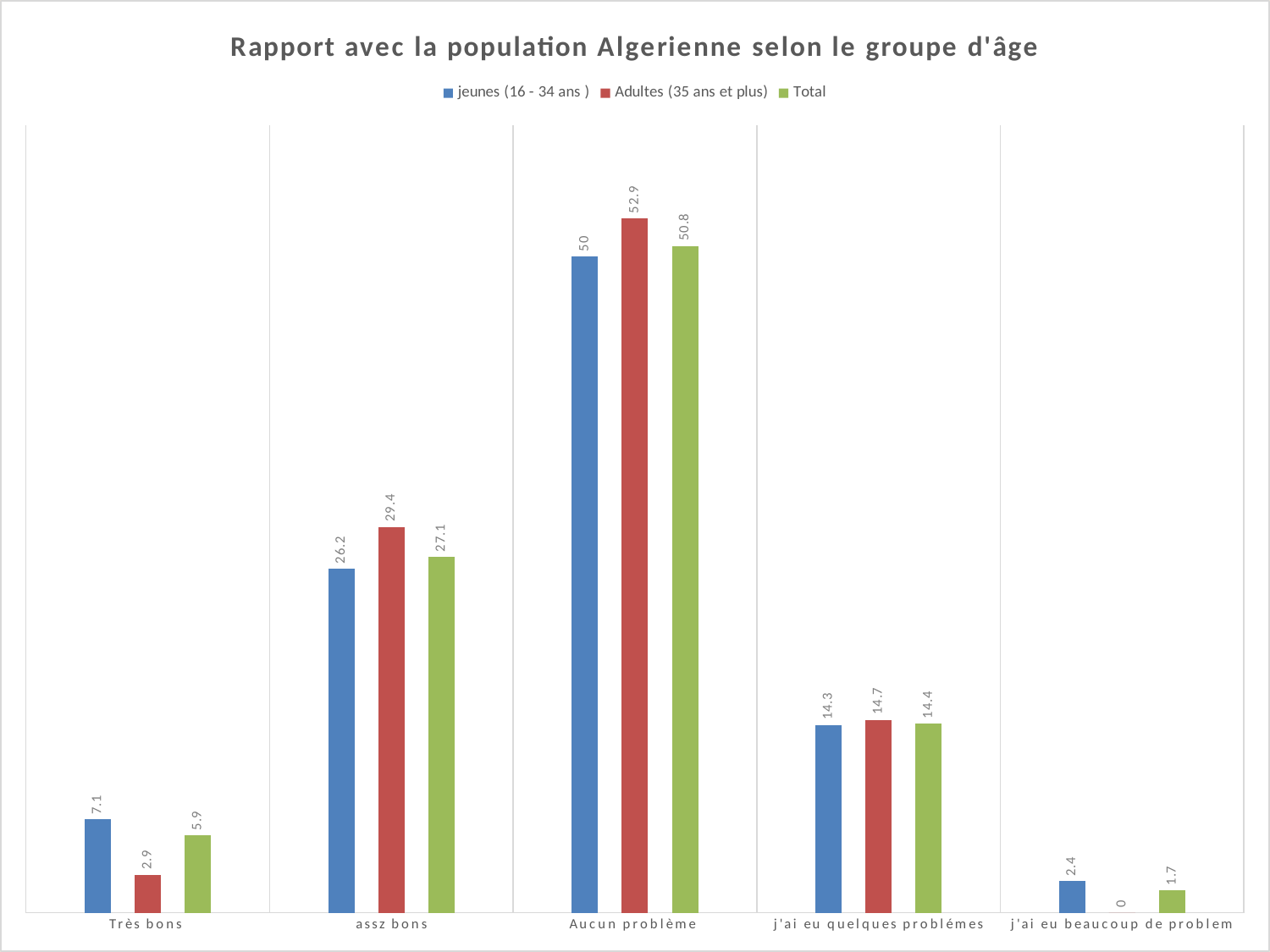
Which category has the highest value for the Total series? Aucun problème What is the difference between the Adultes (35 ans et plus) and jeunes (16 - 34 ans) values for 'assz bons'? 3.2 What is the value for Adultes (35 ans et plus) in the 'j'ai eu beaucoup de problem' category? 0 What is the value for jeunes (16 - 34 ans) in the 'Très bons' category? 7.1 What is the Total value for 'assz bons'? 27.1 How many categories are shown on the x axis? 5 How many series does the legend list? 3 What is the title of the chart? Rapport avec la population Algerienne selon le groupe d'âge In the 'Très bons' category, which is larger: jeunes (16 - 34 ans) or Adultes (35 ans et plus)? jeunes (16 - 34 ans) What kind of chart is shown on the slide? bar chart Which category has the lowest value for jeunes (16 - 34 ans)? j'ai eu beaucoup de problem What is the value for Adultes (35 ans et plus) in the 'Aucun problème' category? 52.9